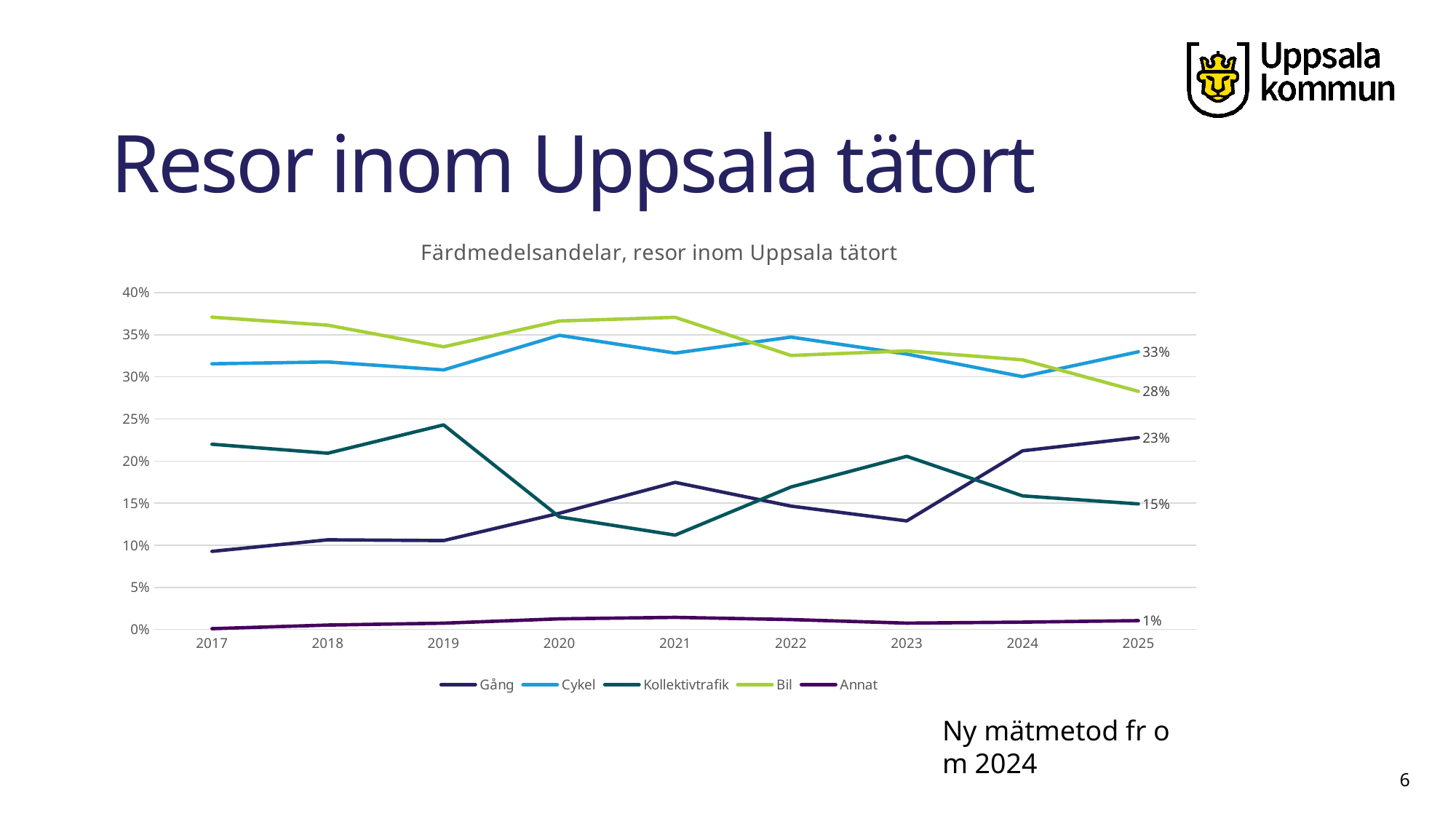
What is the value for Gång in 2025? 23% How many years are shown on the x axis? 9 What is the value for Cykel in 2025? 33% What is the value for Kollektivtrafik in 2025? 15% How many series does the legend list? 5 Is the value for Gång in 2017 greater or less than 10%? less Which series has the lowest value in 2025? Annat What kind of chart is shown on the slide? Line chart In 2017, which is larger: Bil or Cykel? Bil Which series has the highest value in 2025? Cykel What is the value for Bil in 2025? 28% What is the difference between the Cykel and Bil values in 2025? 5 percentage points